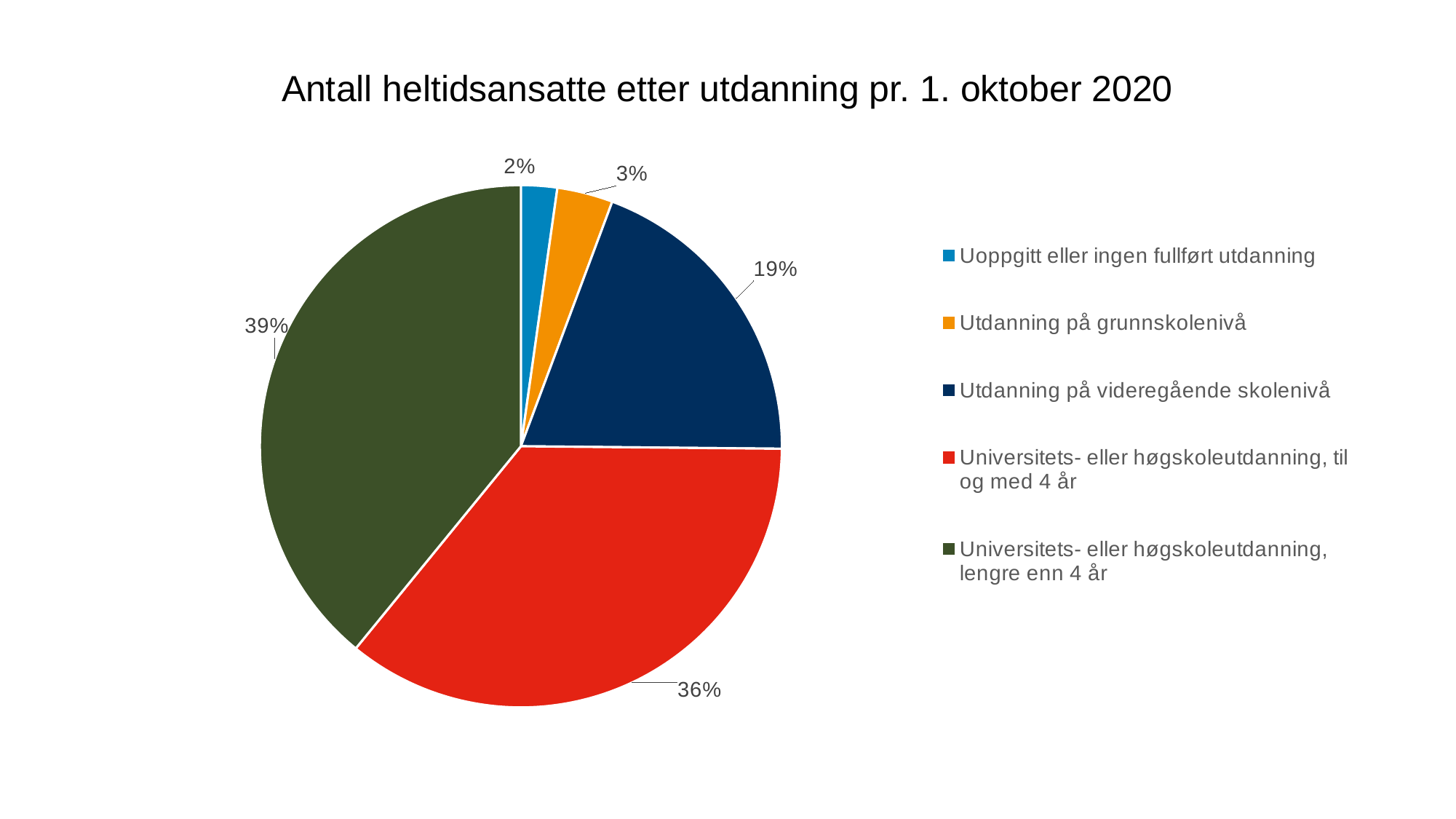
Which category has the smallest slice? Uoppgitt eller ingen fullført utdanning What kind of chart is shown on the slide? pie chart Which is larger: the slice for 'Utdanning på grunnskolenivå' or the slice for 'Uoppgitt eller ingen fullført utdanning'? Utdanning på grunnskolenivå How many categories does the pie chart have? 5 Which category has the largest slice? Universitets- eller høgskoleutdanning, lengre enn 4 år What is the difference in percentage points between 'Universitets- eller høgskoleutdanning, til og med 4 år' and 'Utdanning på videregående skolenivå'? 17 percentage points What share of the pie is 'Utdanning på videregående skolenivå'? 19% What share of the pie is 'Universitets- eller høgskoleutdanning, lengre enn 4 år'? 39% What share of the pie is 'Universitets- eller høgskoleutdanning, til og med 4 år'? 36% What is the title of the chart? Antall heltidsansatte etter utdanning pr. 1. oktober 2020